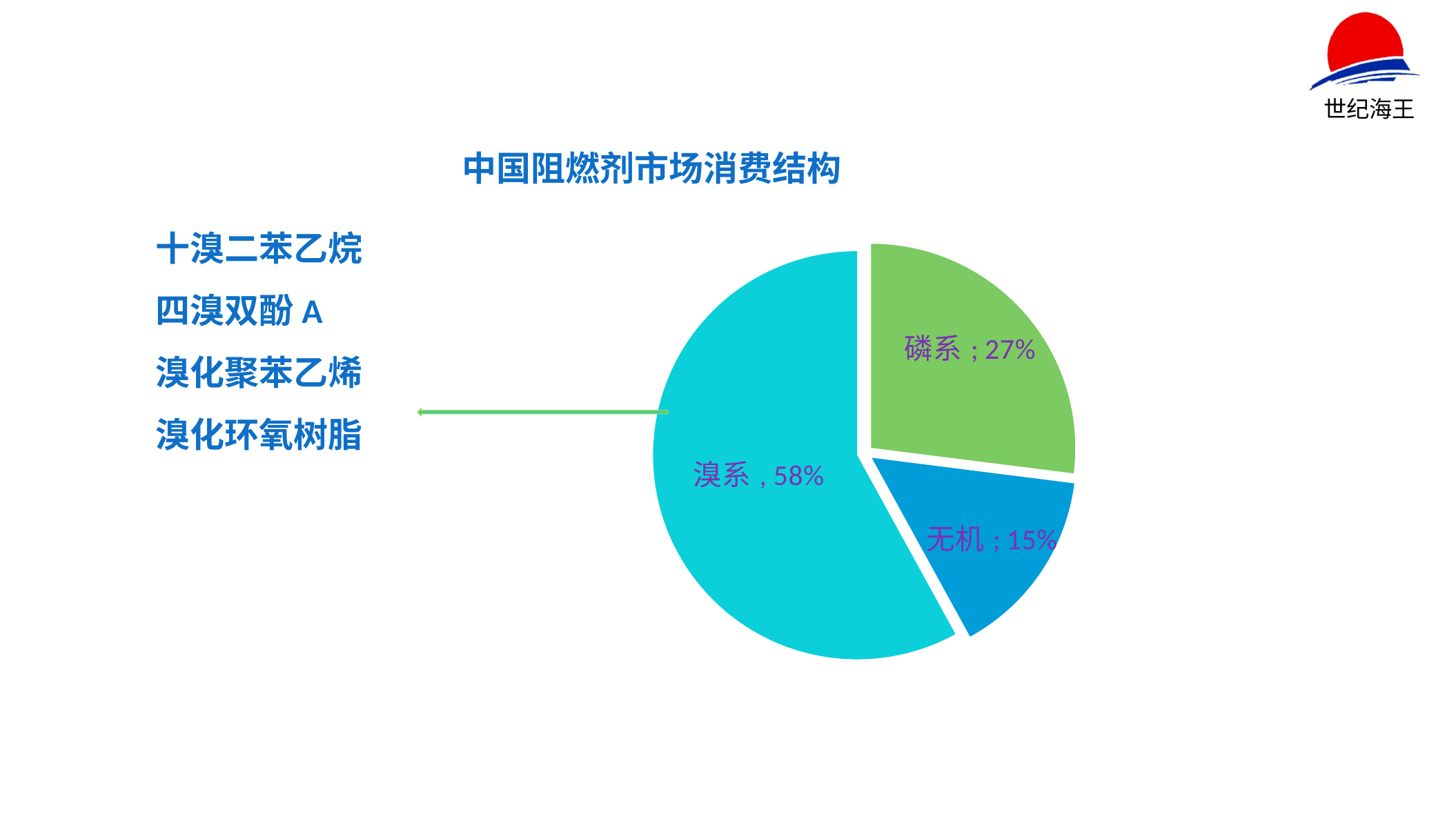
What is the difference in percentage points between 磷系 and 无机? 12 Which category has the largest slice of the pie? 溴系 What share of the pie does 溴系 hold? 58% How many slices does the pie chart have? 3 What is the difference in percentage points between 溴系 and 磷系? 31 What kind of chart is shown on the slide? pie chart What is the title of the chart? 中国阻燃剂市场消费结构 Which category has the smallest slice of the pie? 无机 What colour is the 溴系 slice? cyan What share of the pie does 无机 hold? 15% What share of the pie does 磷系 hold? 27% Which is larger, the share for 磷系 or the share for 无机? 磷系